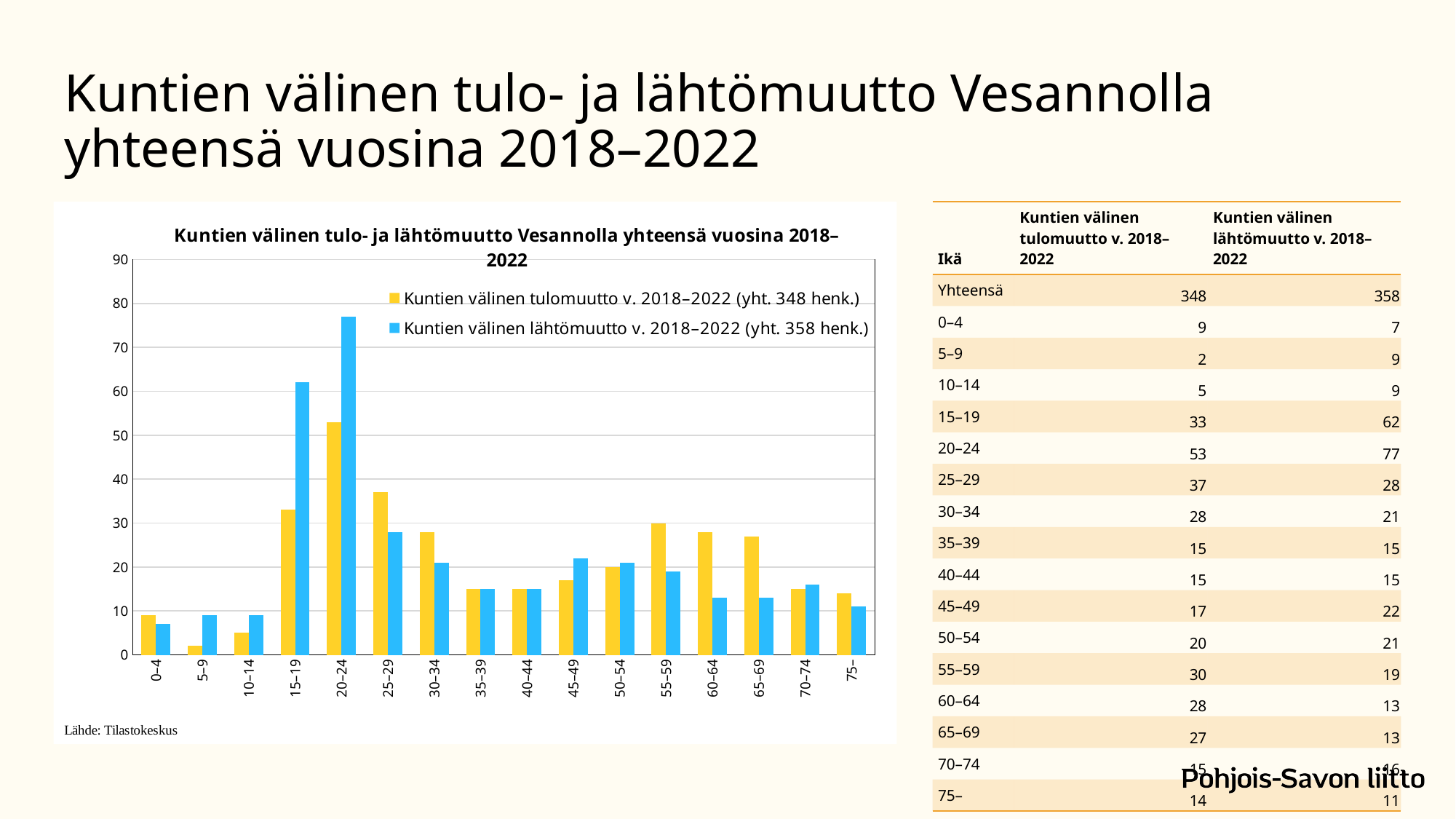
What kind of chart is shown on the slide? bar chart How many age groups are shown on the x axis of the chart? 16 Which age group has the lowest value for Kuntien välinen tulomuutto v. 2018–2022? 5–9 What is the value of Kuntien välinen tulomuutto v. 2018–2022 for the 20–24 age group? 53 For the 25–29 age group, which is larger: tulomuutto or lähtömuutto? tulomuutto How many series does the chart's legend list? 2 Is the tulomuutto value for the 55–59 age group greater or less than 20? greater According to the legend, what is the total number of people for Kuntien välinen tulomuutto v. 2018–2022? 348 henk. Which age group has the highest value for Kuntien välinen lähtömuutto v. 2018–2022? 20–24 Is the lähtömuutto value for the 20–24 age group greater or less than 70? greater What is the value of Kuntien välinen lähtömuutto v. 2018–2022 for the 15–19 age group? 62 For the 20–24 age group, what is the difference between lähtömuutto and tulomuutto? 24